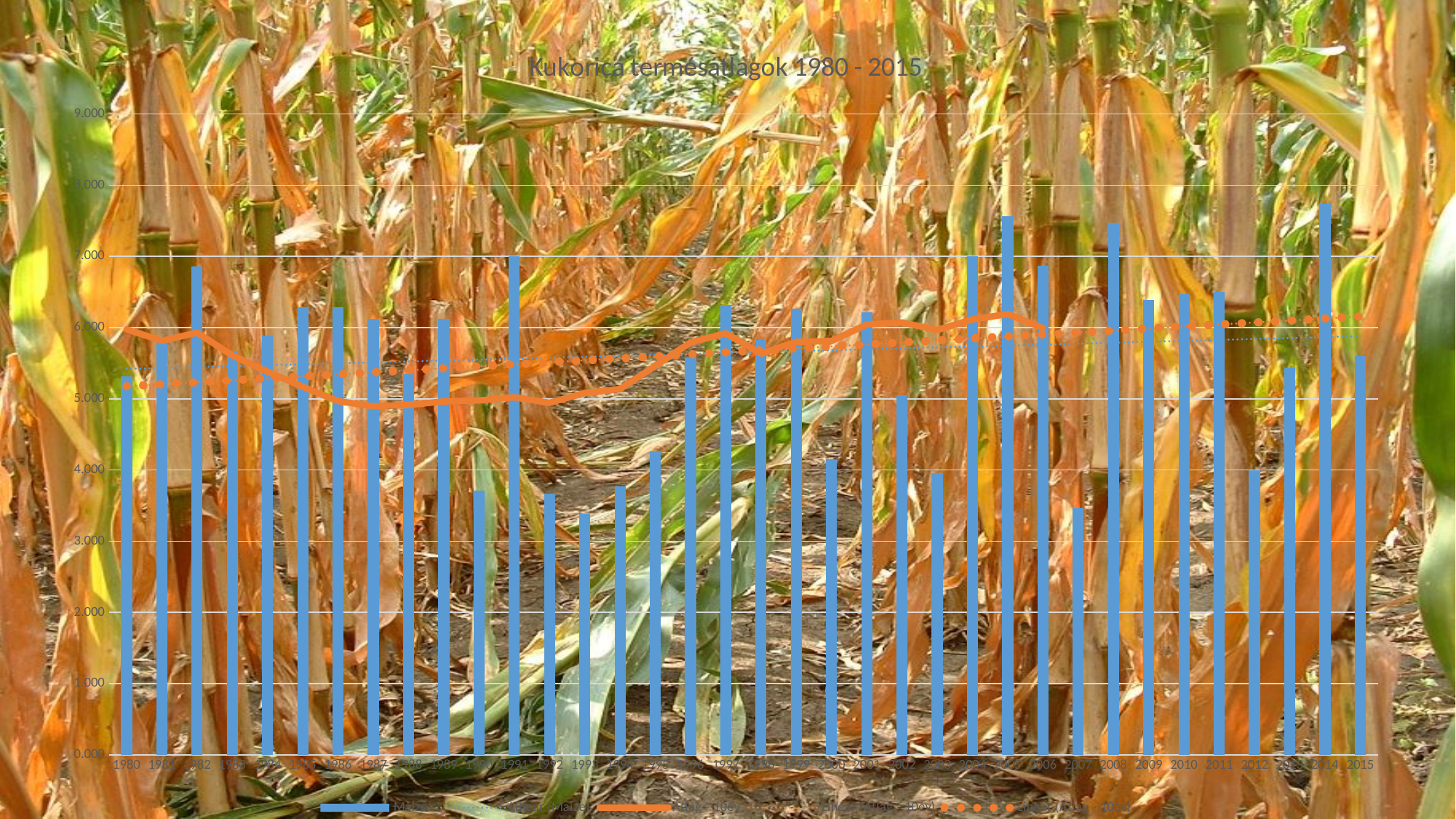
Which year has the taller bar, 1982 or 1983? 1982 Is the bar value for 1982 greater or less than 6.000? greater Is the bar value for 2005 greater or less than 7.000? greater What is the highest value shown on the vertical axis? 9.000 Is the bar value for 2014 greater or less than 7.000? greater What kind of chart is used to show the yearly values? bar chart How many years (bars) are plotted on the x axis? 36 What is the title of the chart? Kukorica termésátlagok 1980 - 2015 Which year has the taller bar, 2005 or 2007? 2005